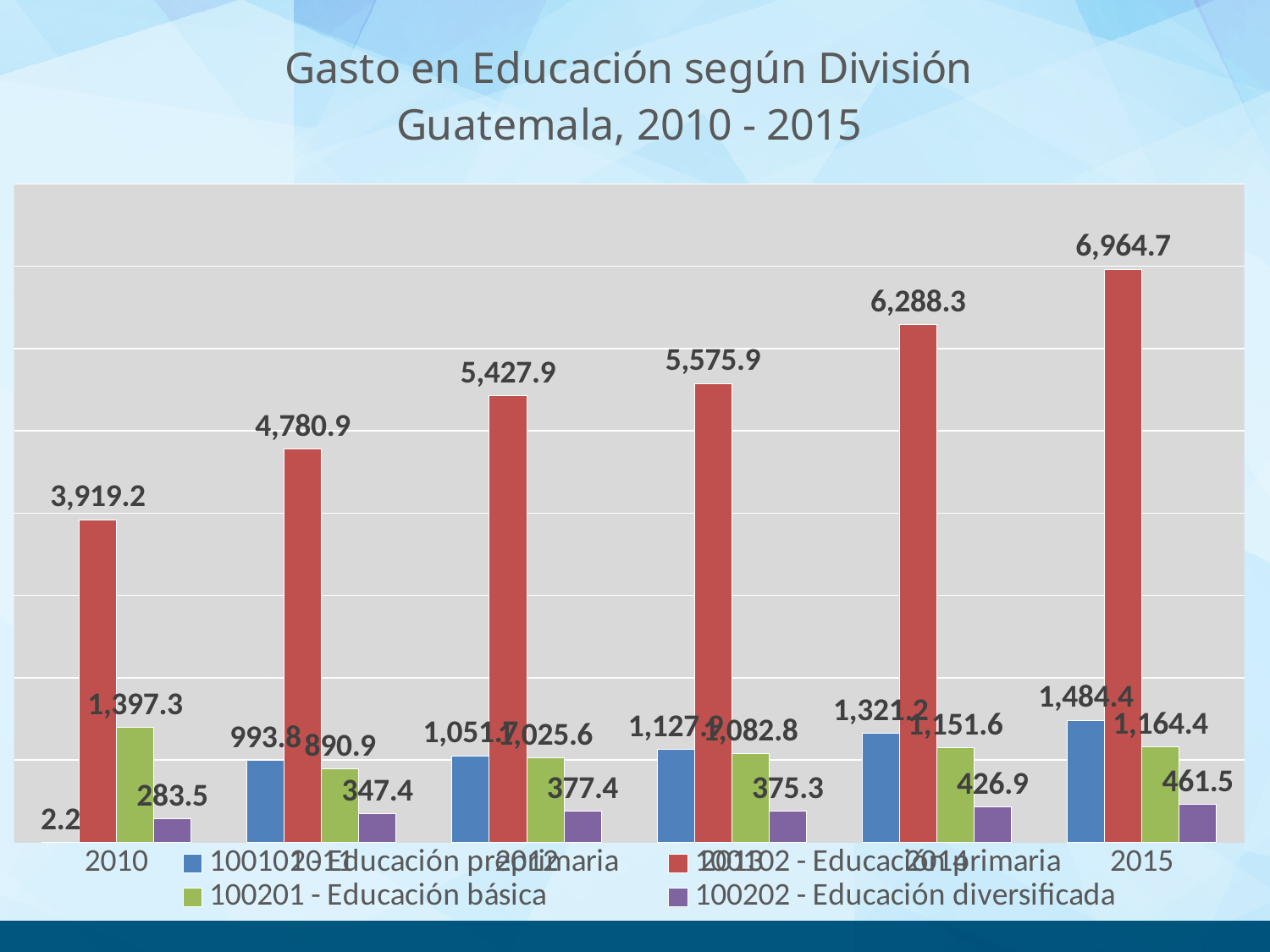
What is the value for Educación primaria in 2010? 3,919.2 What is the value for Educación diversificada in 2014? 426.9 What is the difference between the Educación primaria values for 2015 and 2014? 676.4 Does the value for Educación primaria rise or fall from 2010 to 2015? rise In which year is the value for Educación primaria highest? 2015 Which is larger in 2011: Educación preprimaria or Educación básica? Educación preprimaria What is the value for Educación básica in 2010? 1,397.3 How many series does the legend list? 4 What type of chart is shown on the slide? bar chart What is the value for Educación primaria in 2015? 6,964.7 What is the value for Educación preprimaria in 2015? 1,484.4 In which year is the value for Educación diversificada lowest? 2010